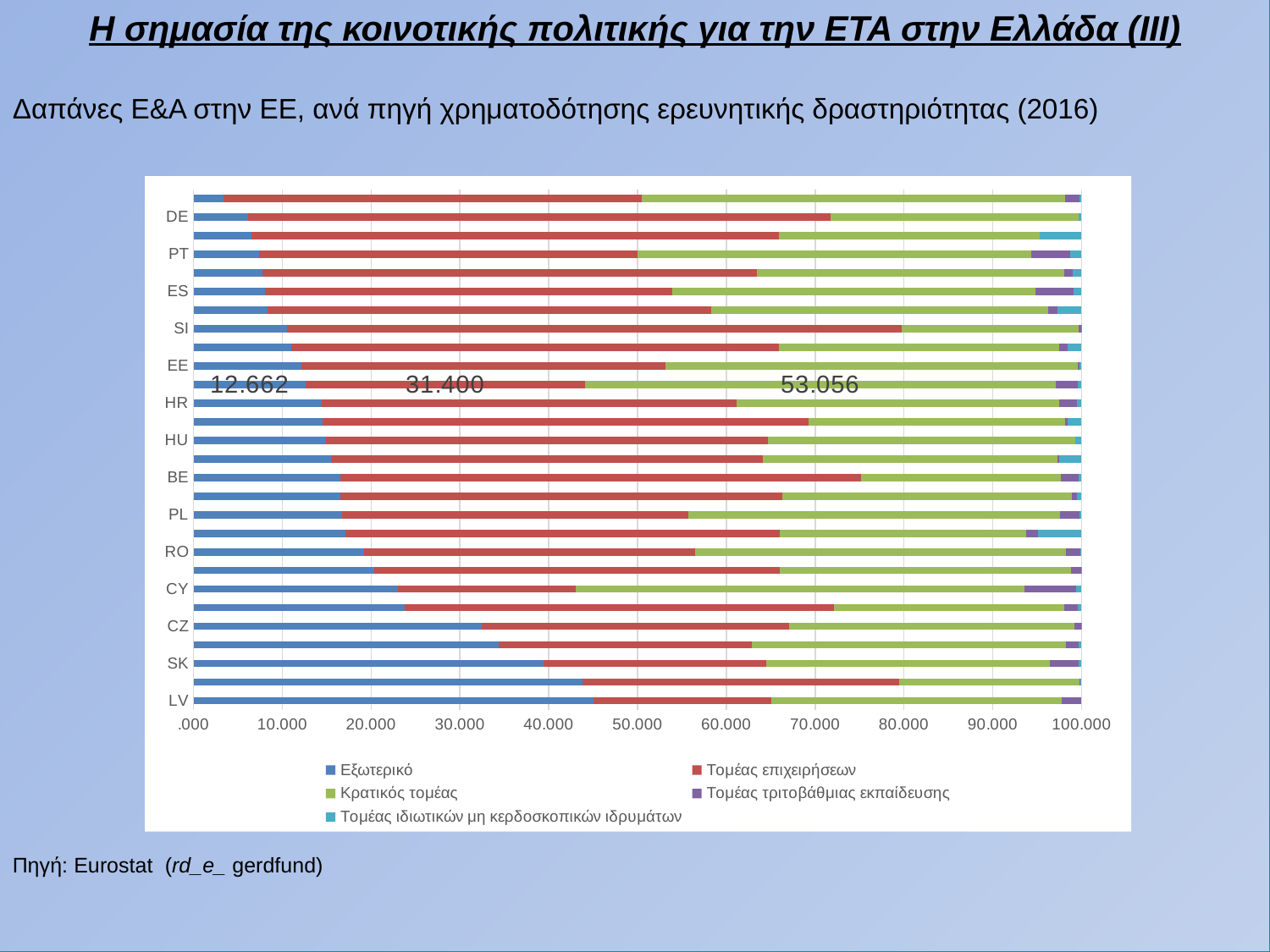
Which has the larger Εξωτερικό (blue) segment, LV or DE? LV What is the highest value shown on the horizontal axis of the chart? 100.000 Which has the larger Τομέας επιχειρήσεων (red) segment, SI or CY? SI What is the printed data label for the Εξωτερικό (blue) segment on the only bar that carries data labels? 12.662 Is the Εξωτερικό (blue) value for CZ greater or less than 30.000? greater Moving down the chart from DE at the top to LV at the bottom, does the Εξωτερικό (blue) segment generally get larger or smaller? larger Is the Εξωτερικό (blue) value for LV greater or less than 40.000? greater How many series does the chart legend list? 5 What is the printed data label for the Τομέας επιχειρήσεων (red) segment on the bar that carries data labels? 31.400 What is the printed data label for the Κρατικός τομέας (green) segment on the bar that carries data labels? 53.056 What kind of chart is shown on the slide? Stacked bar chart Is the Εξωτερικό (blue) value for DE greater or less than 10.000? less